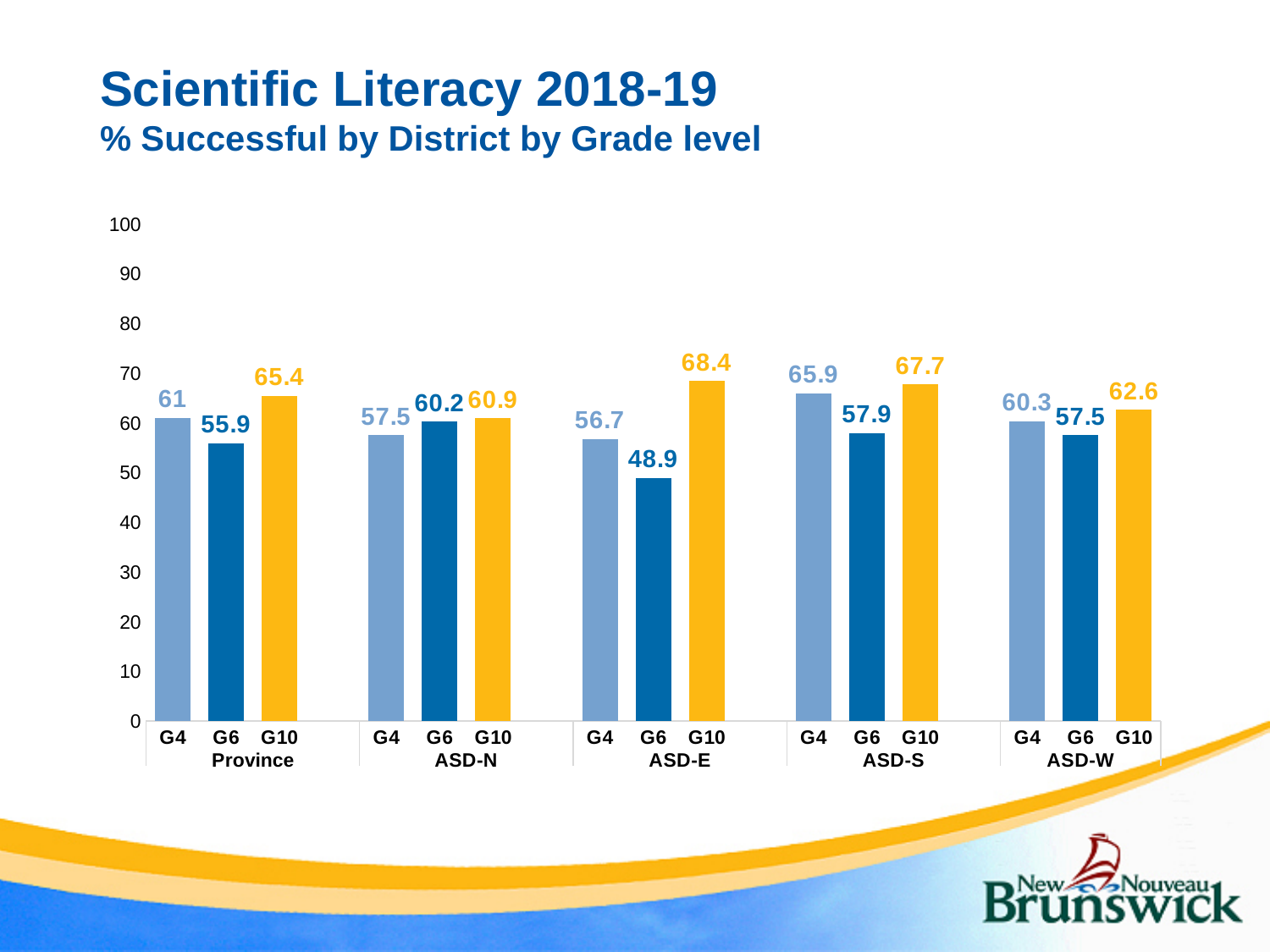
Which bar has the highest value on the chart? G10 in ASD-E (68.4) How many bars are plotted in total on the chart? 15 What is the value for G6 in the Province group? 55.9 What is the value for G10 in ASD-E? 68.4 What is the value for G4 in ASD-S? 65.9 How many district groups are shown on the x axis? 5 Which bar has the lowest value on the chart? G6 in ASD-E (48.9) What kind of chart is shown on the slide? bar chart What is the subtitle of the chart on the slide? % Successful by District by Grade level Is the value for G6 in ASD-E greater or less than 50? less What is the difference between the G10 and G6 values in ASD-E? 19.5 Which is larger, the G4 value in ASD-S or the G4 value in ASD-W? G4 in ASD-S